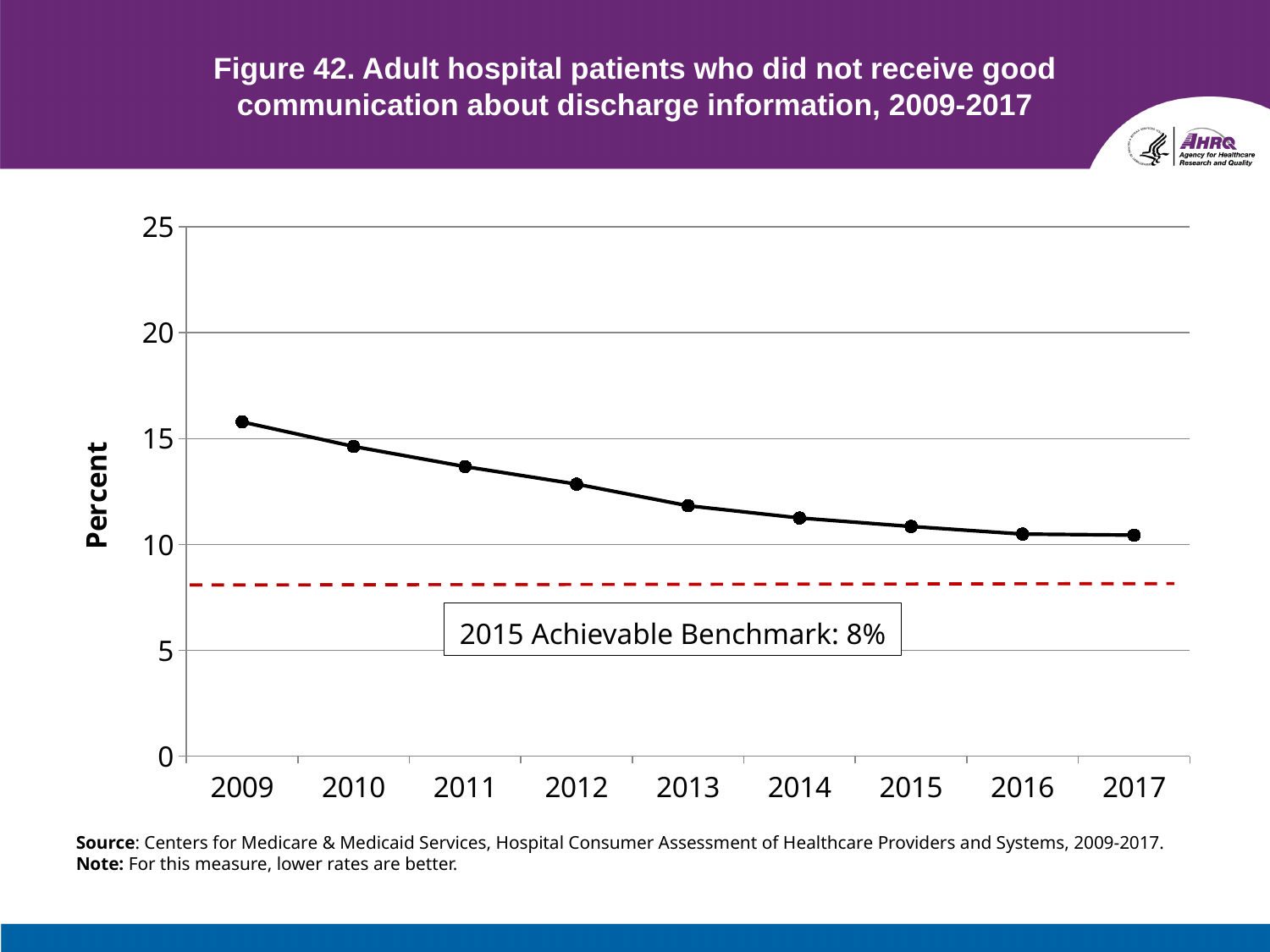
Which year has the highest value? 2009 Is the value for 2017 greater or less than 10? greater Which is larger, the value for 2009 or the value for 2014? 2009 Do the values rise or fall from 2009 to 2017? fall Is the value for 2012 greater or less than 10? greater Is the value for 2009 greater or less than 15? greater What kind of chart is shown on the slide? line chart What is the 2015 Achievable Benchmark shown on the chart? 8% How many years are plotted on the x axis? 9 What is the label on the y axis? Percent